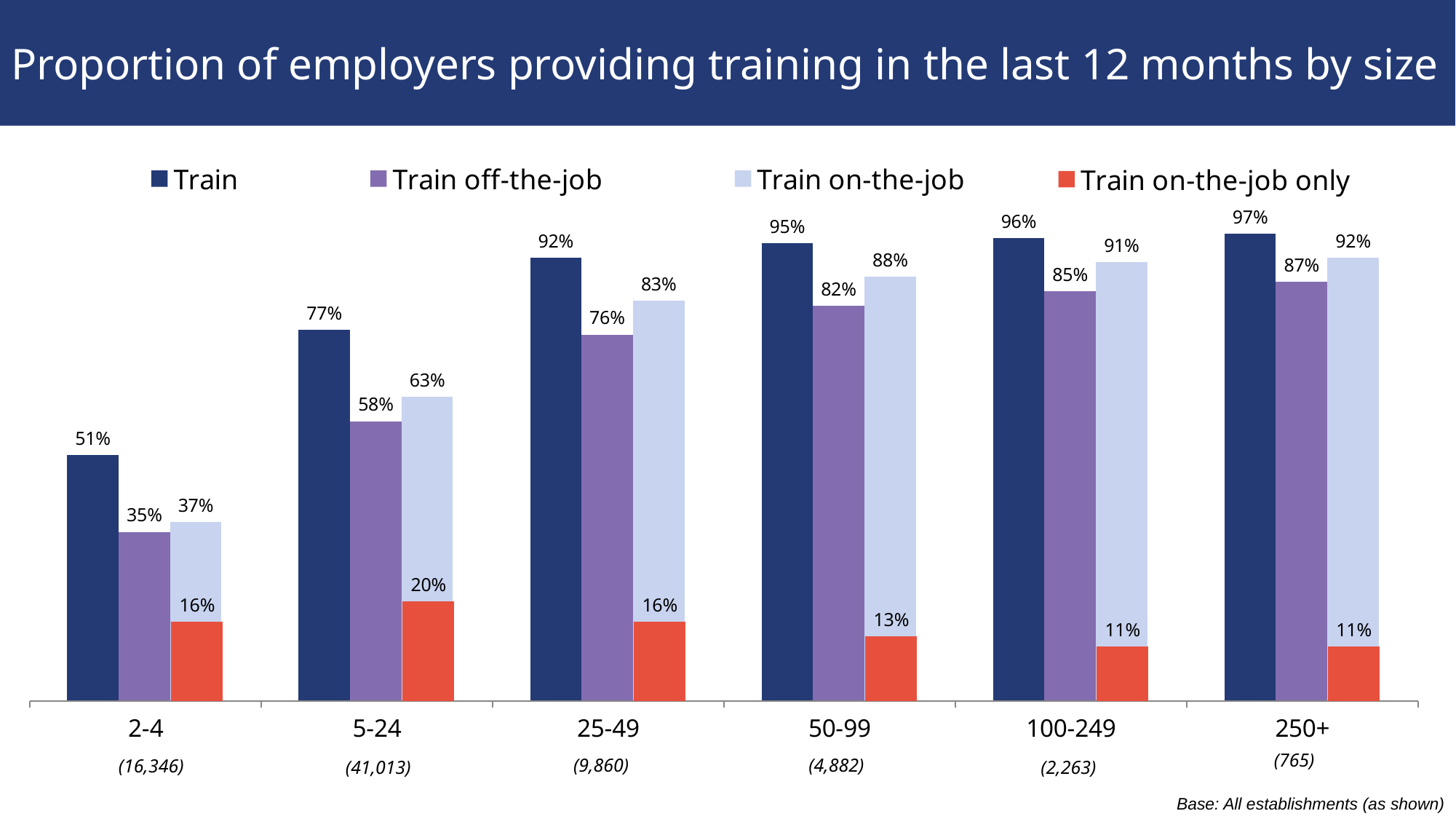
How many series does the legend list? 4 Which size band has the highest value for Train? 250+ What is the value for Train on-the-job only for the 5-24 size band? 20% What is the difference between the Train value and the Train off-the-job value for the 2-4 size band? 16% How many size bands are shown on the x axis? 6 Which is larger for the 25-49 size band: Train off-the-job or Train on-the-job? Train on-the-job What is the base figure shown for the 5-24 size band? (41,013) Which size band has the lowest value for Train on-the-job? 2-4 Do the Train on-the-job only values generally rise or fall as the size band increases from 5-24 to 250+? Fall What kind of chart is shown on the slide? Bar chart What is the value for Train for the 2-4 size band? 51% What is the value for Train off-the-job for the 50-99 size band? 82%